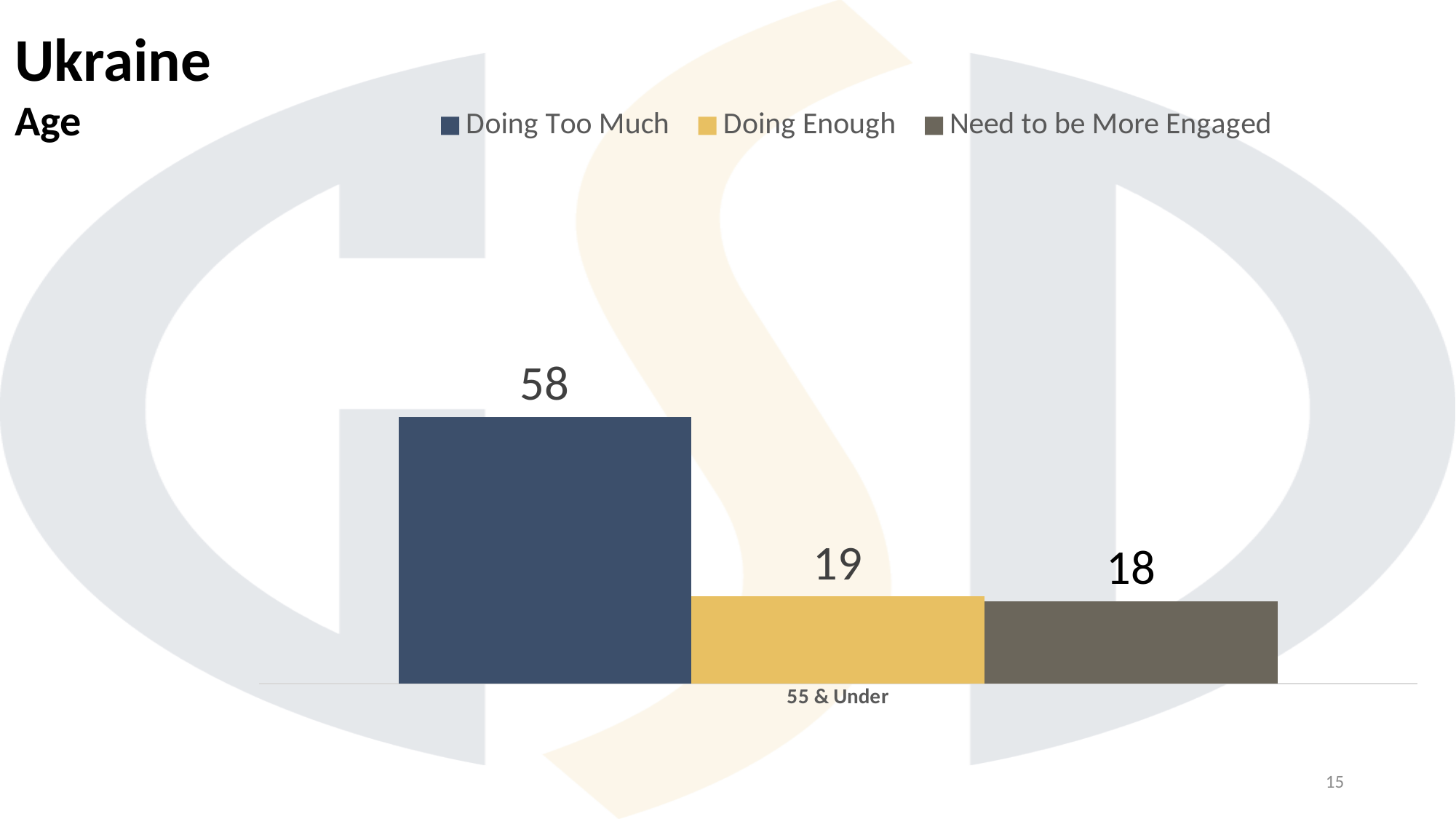
What is the title of the chart? Ukraine Age How many series does the legend list? 3 What is the difference between the Doing Enough value and the Need to be More Engaged value? 1 Which series has the highest value for the 55 & Under group? Doing Too Much What kind of chart is shown on the slide? Bar chart How many categories are shown on the x axis? 1 Which is larger, the value for Doing Too Much or the value for Need to be More Engaged? Doing Too Much What is the difference between the Doing Too Much value and the Doing Enough value? 39 What is the value for Doing Too Much for the 55 & Under group? 58 What colour is the bar for Doing Enough? Yellow What is the value for Doing Enough for the 55 & Under group? 19 What is the value for Need to be More Engaged for the 55 & Under group? 18